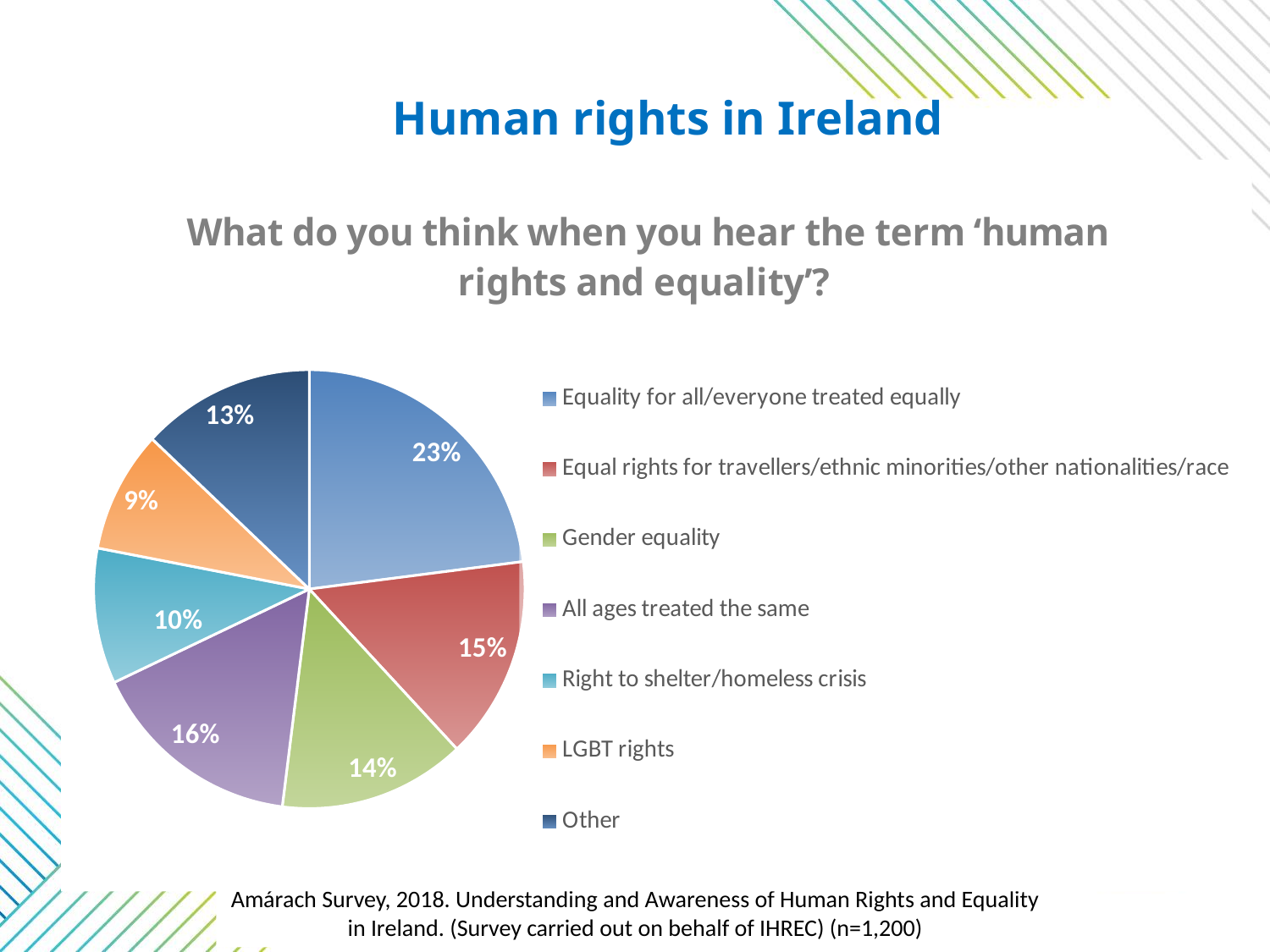
What kind of chart is shown on the slide? Pie chart What is the combined share of 'Gender equality' and 'All ages treated the same'? 30% What percentage is shown for 'Gender equality'? 14% What share of responses is 'Equality for all/everyone treated equally'? 23% What is the difference in percentage points between 'Equality for all/everyone treated equally' and 'Other'? 10 Which category has the largest slice of the pie? Equality for all/everyone treated equally Which is larger: 'All ages treated the same' or 'Equal rights for travellers/ethnic minorities/other nationalities/race'? All ages treated the same What percentage is shown for 'Right to shelter/homeless crisis'? 10% How many categories does the pie chart have? 7 What percentage is shown for 'LGBT rights'? 9% What is the survey question shown above the chart? What do you think when you hear the term 'human rights and equality'? Which category has the smallest slice of the pie? LGBT rights